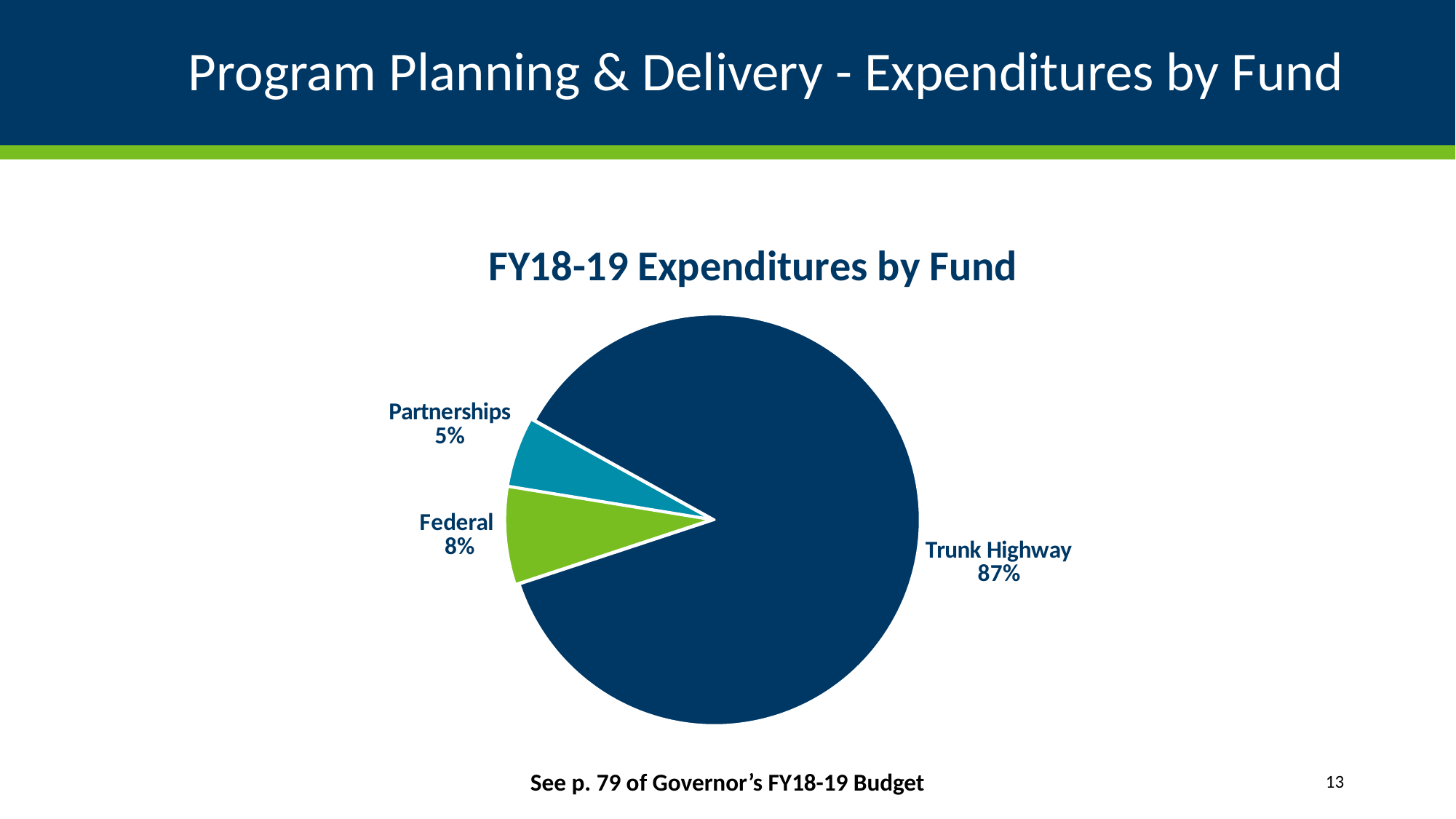
Which fund accounts for the smallest share of expenditures? Partnerships How many slices does the pie chart have? 3 What is the difference in percentage points between the Federal and Partnerships shares? 3 What type of chart is shown on the slide? Pie chart What is the difference in percentage points between the Trunk Highway and Federal shares? 79 Which is larger, the Federal share or the Partnerships share? Federal What share of FY18-19 expenditures comes from the Federal fund? 8% What share of FY18-19 expenditures comes from Partnerships? 5% What colour is the Federal slice? Green What is the title of the chart? FY18-19 Expenditures by Fund Which fund accounts for the largest share of expenditures? Trunk Highway What share of FY18-19 expenditures comes from the Trunk Highway fund? 87%